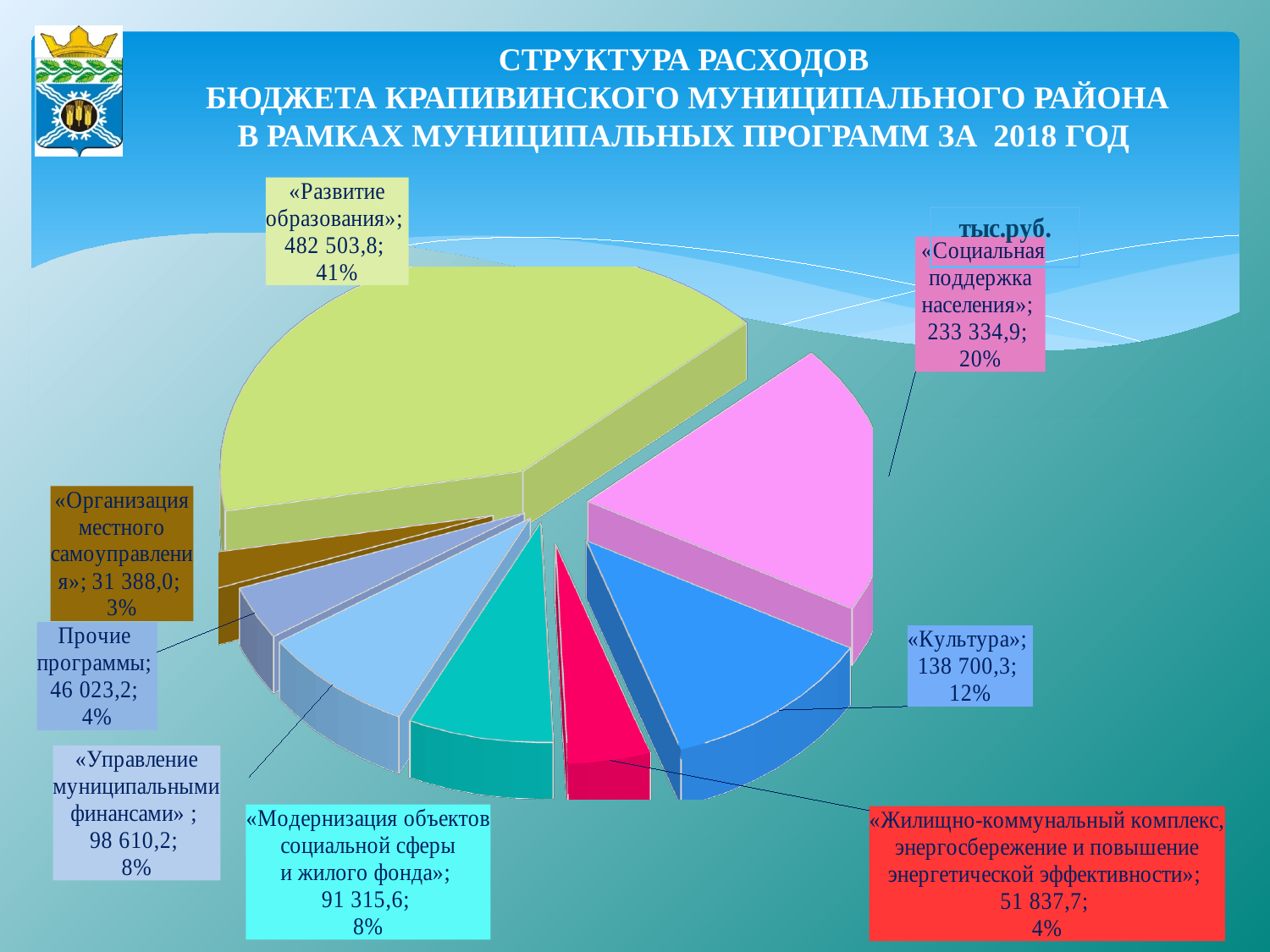
In what units are the values on the chart given? тыс.руб. Which is larger: the value for «Управление муниципальными финансами» or for «Модернизация объектов социальной сферы и жилого фонда»? «Управление муниципальными финансами» Which programme has the smallest share of expenditure? «Организация местного самоуправления» What is the difference between the values for «Развитие образования» and «Социальная поддержка населения»? 249 168,9 What kind of chart is shown on the slide? pie chart How many slices (programmes) does the pie chart have? 8 Which programme has the largest share of expenditure? «Развитие образования» What is the value for «Социальная поддержка населения»? 233 334,9 What share of the pie does «Культура» represent? 12% What is the value for «Развитие образования»? 482 503,8 What share of the pie does «Организация местного самоуправления» represent? 3% What is the value for «Управление муниципальными финансами»? 98 610,2